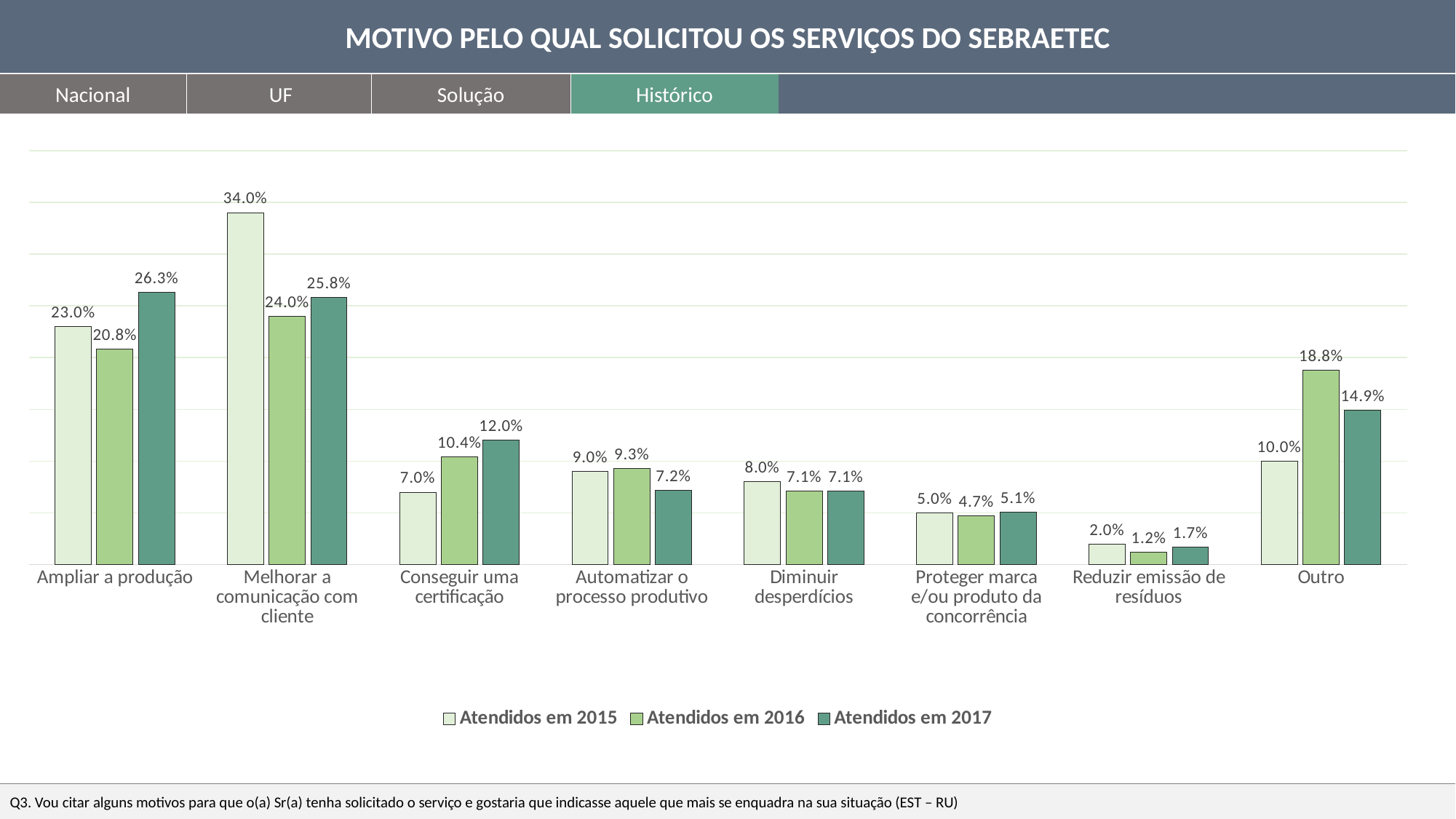
Which category has the lowest value in the "Atendidos em 2016" series? Reduzir emissão de resíduos Which tab is highlighted in the navigation bar above the chart? Histórico What is the value for "Conseguir uma certificação" in the "Atendidos em 2017" series? 12.0% Which category has the highest value in the "Atendidos em 2017" series? Ampliar a produção What is the value for "Melhorar a comunicação com cliente" in the "Atendidos em 2015" series? 34.0% How many series does the legend list? 3 What is the difference between the "Atendidos em 2015" and "Atendidos em 2017" values for "Ampliar a produção"? 3.3% For "Outro", which series has the larger value: "Atendidos em 2016" or "Atendidos em 2017"? Atendidos em 2016 How many categories are shown on the x axis? 8 What is the value for "Outro" in the "Atendidos em 2016" series? 18.8% What is the difference between the "Atendidos em 2015" and "Atendidos em 2016" values for "Melhorar a comunicação com cliente"? 10.0% What kind of chart is shown on the slide? Bar chart